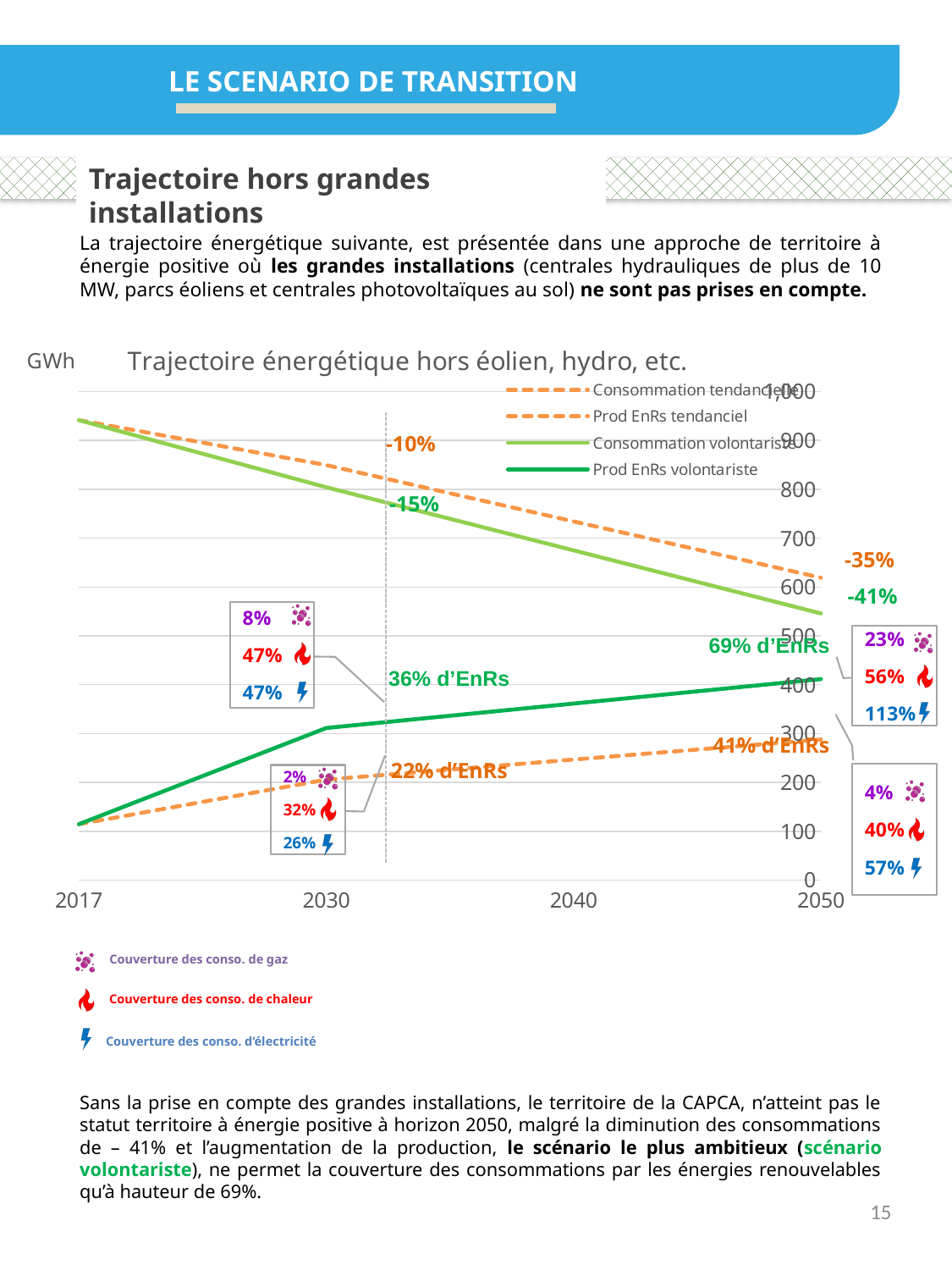
What kind of chart is shown on the slide? line chart Does the Prod EnRs volontariste line rise or fall from 2017 to 2050? rise Is the value of Consommation tendanciel in 2050 greater or less than 600? greater Does the Consommation volontariste line rise or fall from 2017 to 2050? fall Is the value of Consommation volontariste in 2050 greater or less than 600? less What unit is shown for the y axis of the chart? GWh How many years are labelled on the x axis of the chart? 4 How many series does the chart legend list? 4 In 2050, which is higher: Consommation tendanciel or Consommation volontariste? Consommation tendanciel What share of EnRs is annotated for the volontariste scenario at 2050? 69% d'EnRs What percentage change is annotated at 2050 for the Consommation volontariste line? -41%